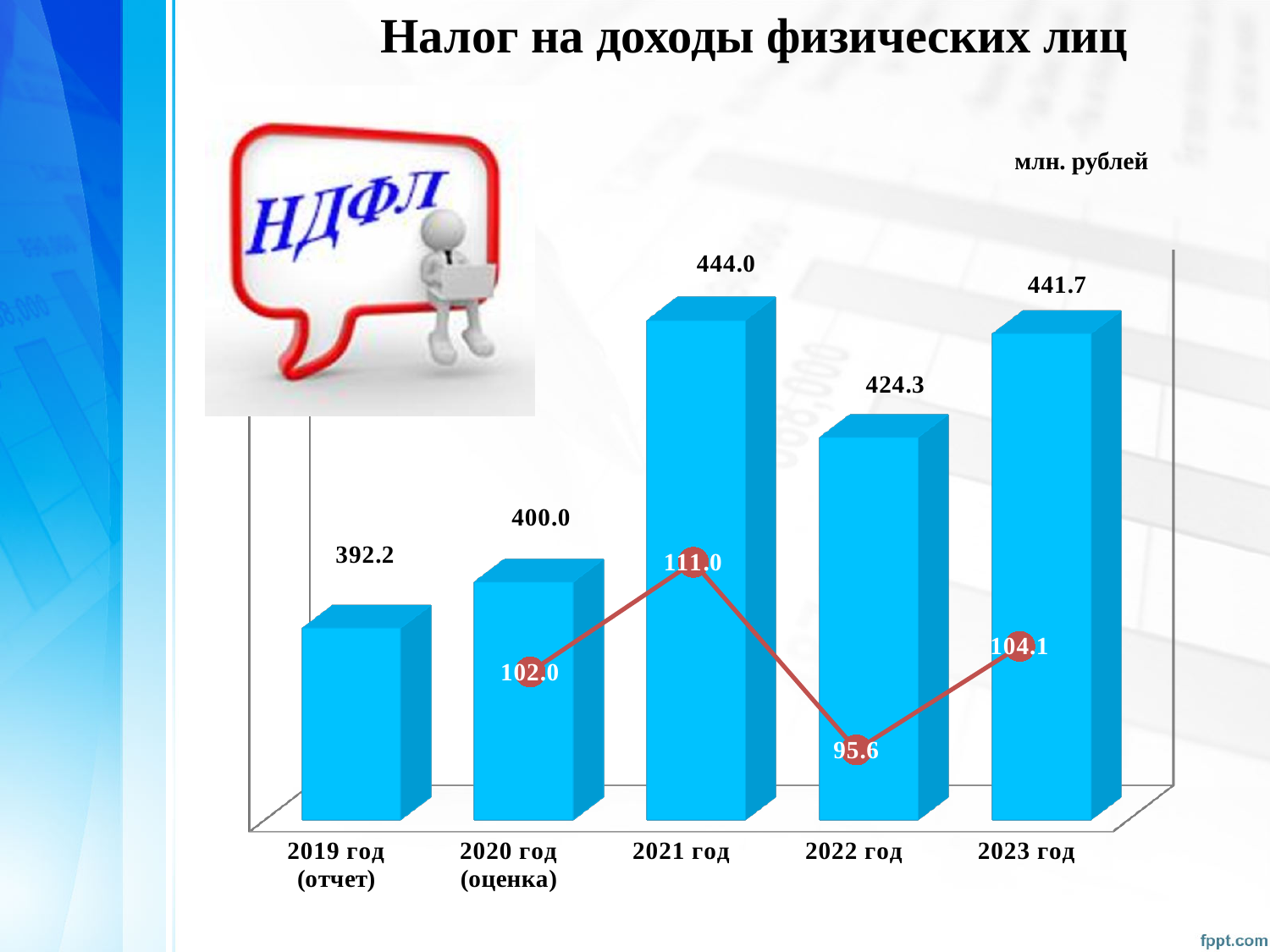
Which year has the lowest bar value? 2019 год (отчет) Which year has the highest bar value? 2021 год What is the value of the bar for 2019 год (отчет)? 392.2 What is the value of the bar for 2023 год? 441.7 What type of chart is this? Bar chart with a line overlay Which year has the highest line point value? 2021 год What is the value of the line point for 2022 год? 95.6 How many years are shown on the x axis? 5 Which is larger, the bar value for 2020 год (оценка) or for 2022 год? 2022 год What unit of measurement is indicated on the chart? млн. рублей What is the value of the bar for 2021 год? 444.0 What is the difference between the bar values for 2021 год and 2022 год? 19.7